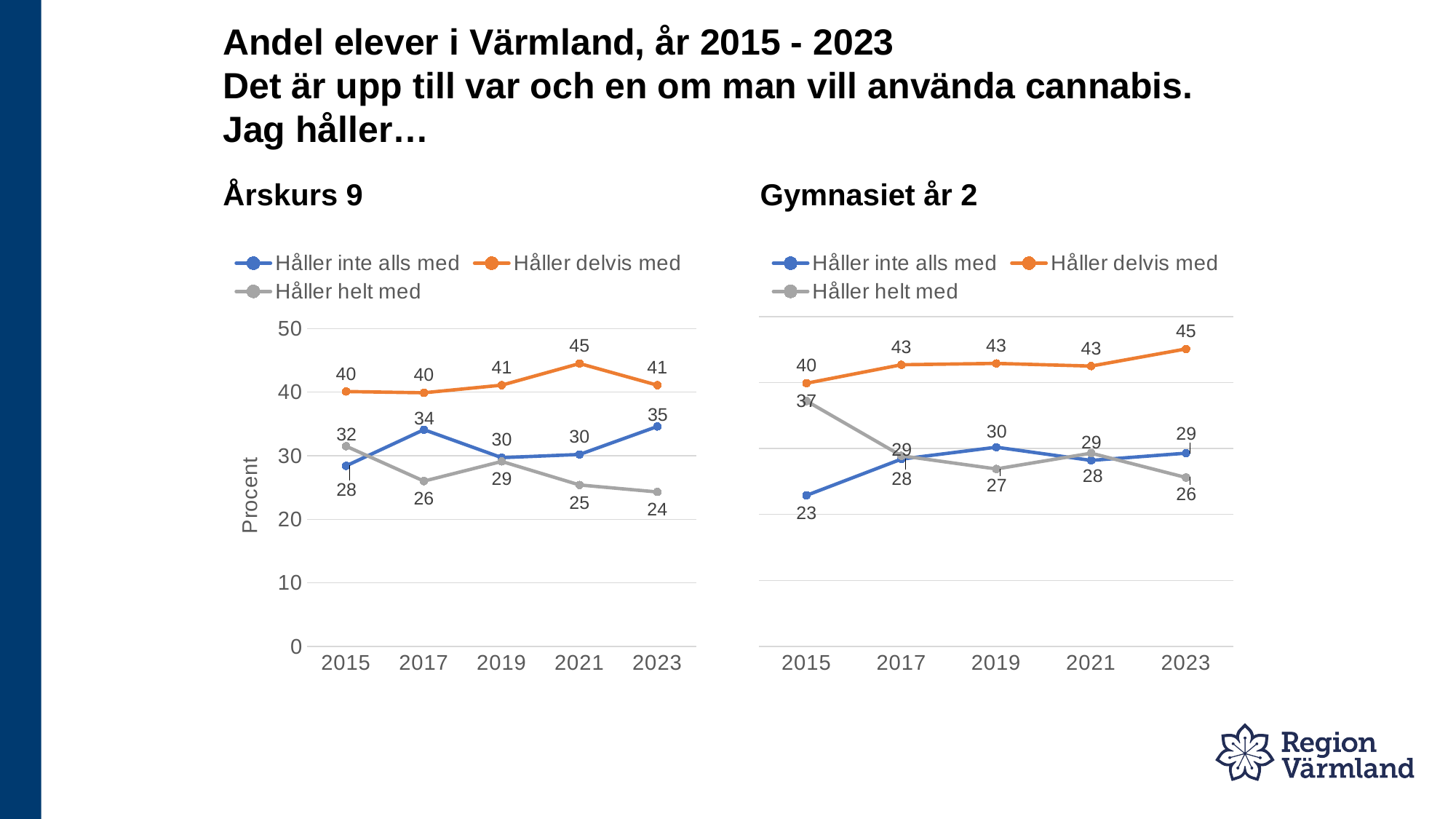
In the Gymnasiet år 2 chart, what is the value for Håller inte alls med in 2015? 23 In the Gymnasiet år 2 chart, in which year is Håller delvis med highest? 2023 How many series does the legend of the Gymnasiet år 2 chart list? 3 How many years are shown on the x axis of the Årskurs 9 chart? 5 In the Årskurs 9 chart, what is the value for Håller helt med in 2023? 24 In the Gymnasiet år 2 chart, does Håller helt med rise or fall from 2015 to 2017? fall In the Gymnasiet år 2 chart, what is the difference between Håller helt med in 2015 and in 2023? 11 In the Årskurs 9 chart, which is larger in 2017: Håller inte alls med or Håller helt med? Håller inte alls med In the Årskurs 9 chart, what is the value for Håller delvis med in 2021? 45 What kind of chart is the Årskurs 9 chart? line chart In the Årskurs 9 chart, in which year is Håller helt med lowest? 2023 In the Gymnasiet år 2 chart, is the value for Håller delvis med in 2015 greater or less than 30? greater